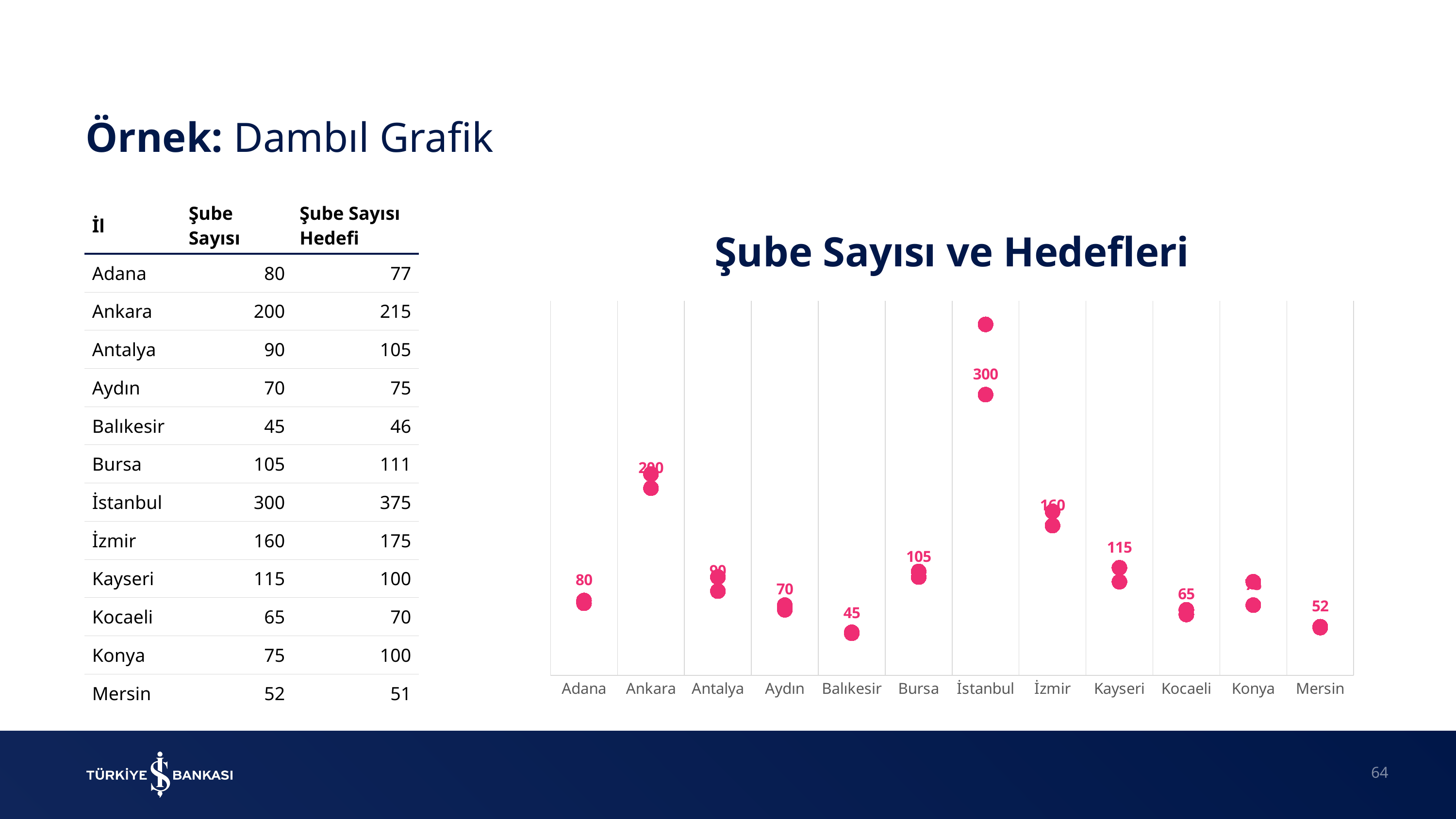
What is the difference between the labelled Şube Sayısı values for Adana and Aydın in the chart? 10 How many cities are shown on the x axis of the chart? 12 What is the labelled Şube Sayısı value for Bursa in the chart? 105 Which city has the lowest labelled Şube Sayısı value in the chart? Balıkesir What is the labelled Şube Sayısı value for Balıkesir in the chart? 45 What is the labelled Şube Sayısı value for İstanbul in the chart? 300 What kind of chart is shown on the slide? Dot plot (dumbbell chart) What is the difference between the labelled Şube Sayısı values for İstanbul and Bursa in the chart? 195 What is the labelled Şube Sayısı value for Mersin in the chart? 52 Which city has the highest values in the chart? İstanbul Which has the larger labelled Şube Sayısı value in the chart, Kayseri or Kocaeli? Kayseri What is the title of the chart on the slide? Şube Sayısı ve Hedefleri